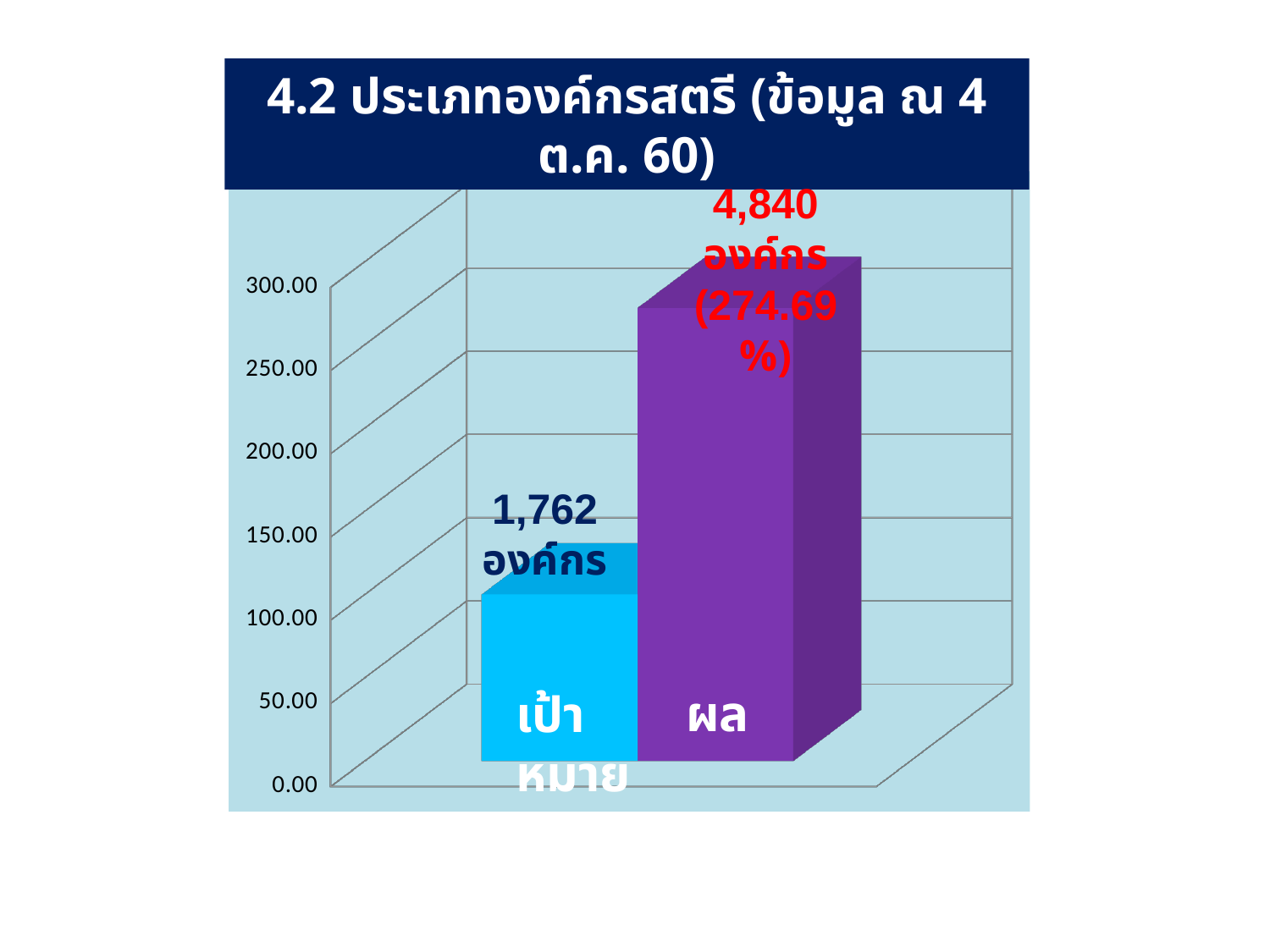
What is the highest tick value shown on the vertical axis? 300.00 What kind of chart is shown on the slide? bar chart Is the bar for เป้าหมาย greater or less than 150.00 on the axis? less How many bars are plotted in the chart? 2 How many organisations are shown for ผล? 4,840 องค์กร Which category has the taller bar, เป้าหมาย or ผล? ผล Which category has the shorter bar in the chart? เป้าหมาย How many organisations are shown for เป้าหมาย? 1,762 องค์กร What percentage is shown next to the ผล bar? 274.69% By how many organisations does ผล exceed เป้าหมาย? 3,078 What is the title of the chart? 4.2 ประเภทองค์กรสตรี (ข้อมูล ณ 4 ต.ค. 60) Is the bar for ผล greater or less than 250.00 on the axis? greater